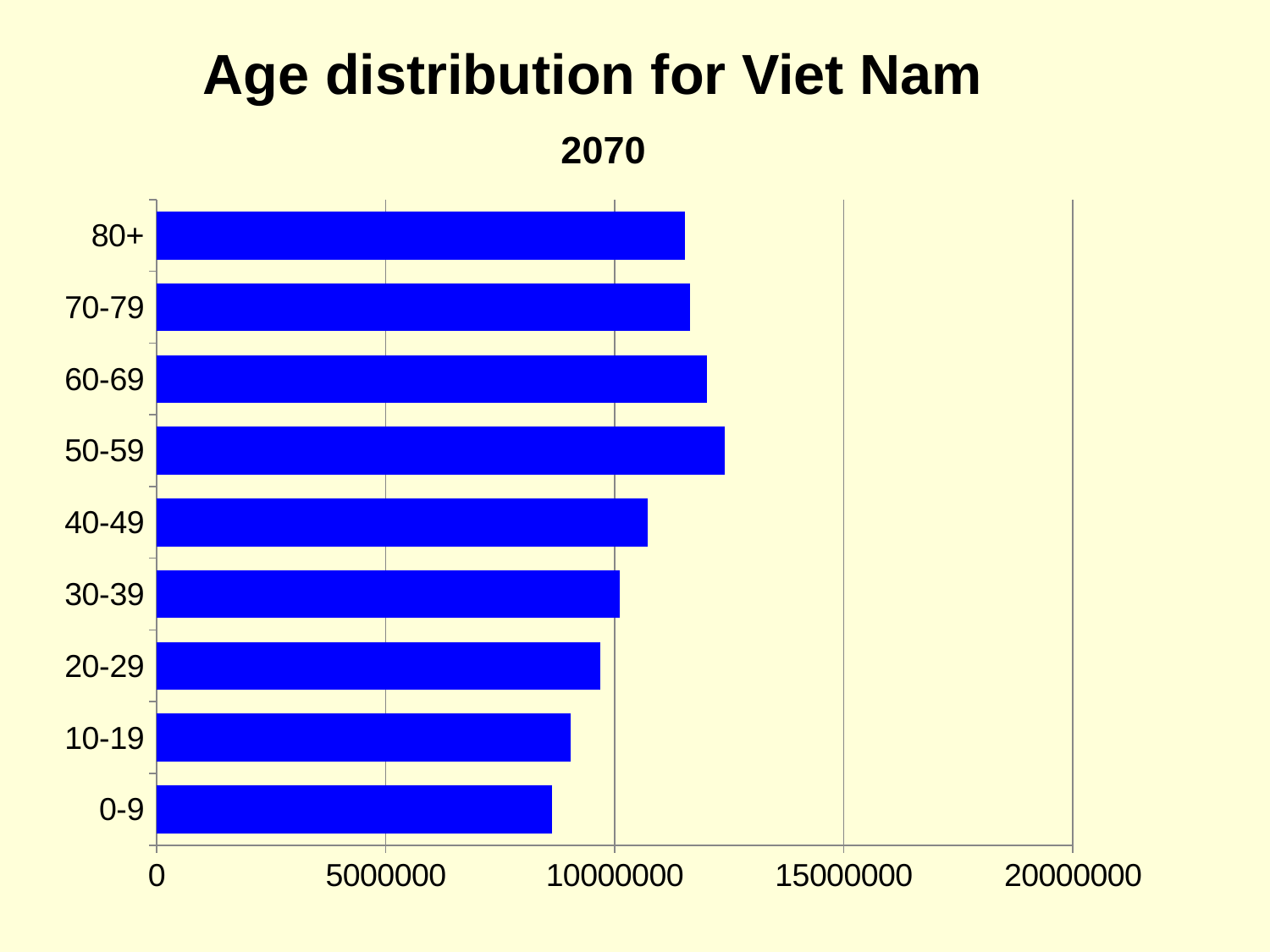
Which age group has the lowest value? 0-9 Which age group has the highest value? 50-59 Which is larger, the value for 20-29 or the value for 50-59? 50-59 What kind of chart is shown on the slide? bar chart Is the value for the 10-19 age group greater or less than 10000000? less What year does the chart's subtitle give for the age distribution? 2070 Is the value for the 50-59 age group greater or less than 10000000? greater Which is larger, the value for 60-69 or the value for 40-49? 60-69 Is the value for the 60-69 age group greater or less than 15000000? less How many age groups are plotted in the chart? 9